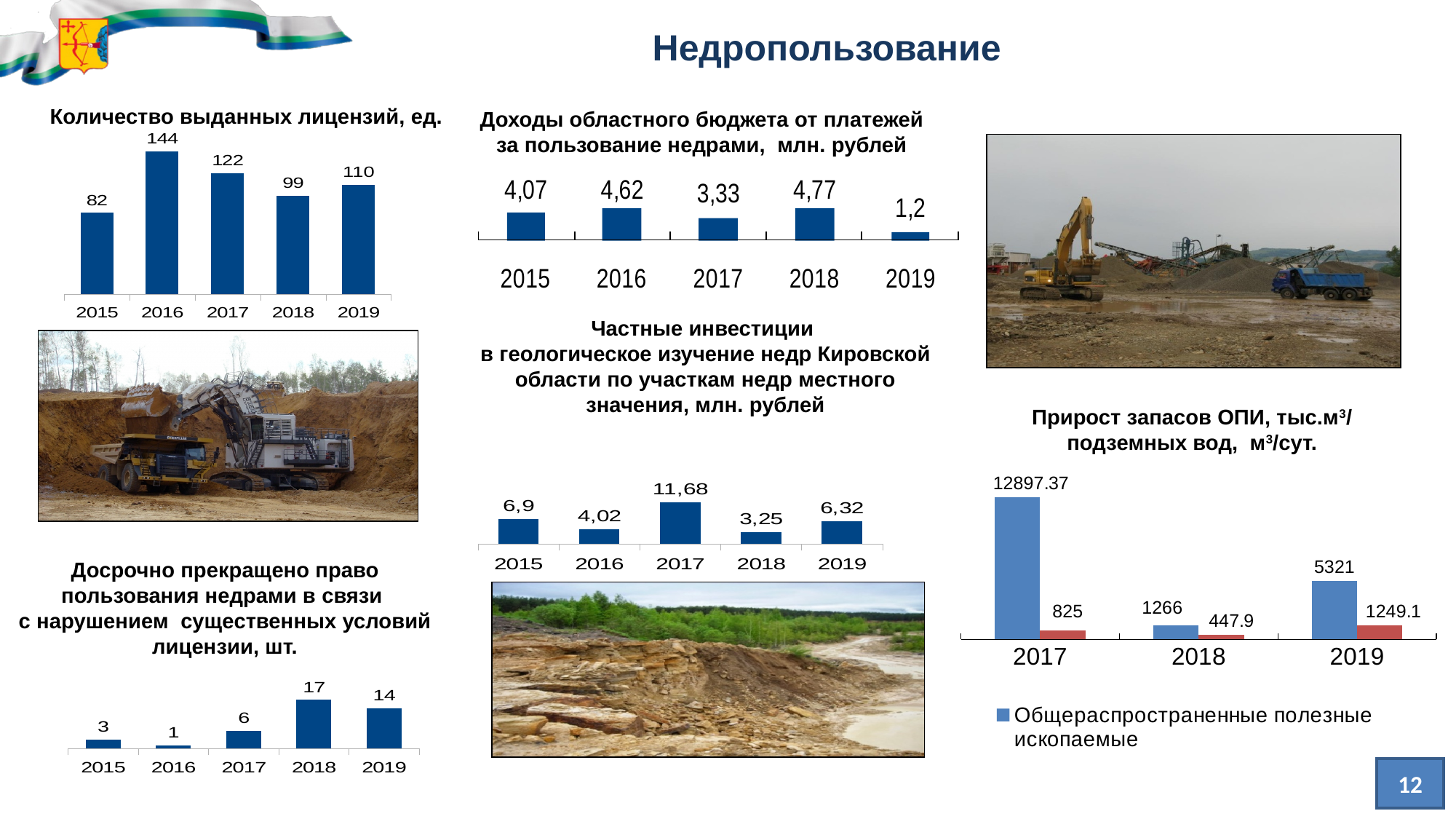
In the chart 'Доходы областного бюджета от платежей за пользование недрами, млн. рублей', what is the value for 2019? 1,2 In the chart 'Досрочно прекращено право пользования недрами в связи с нарушением существенных условий лицензии, шт.', how many years are shown on the x axis? 5 In the chart 'Частные инвестиции в геологическое изучение недр Кировской области по участкам недр местного значения, млн. рублей', which is larger, the value for 2015 or 2019? 2015 In the chart 'Количество выданных лицензий, ед.', which year has the lowest value? 2015 In the chart 'Прирост запасов ОПИ, тыс.м³/ подземных вод, м³/сут.', what is the value of the red bar for 2018? 447.9 In the chart 'Количество выданных лицензий, ед.', what is the value for 2016? 144 In the chart 'Доходы областного бюджета от платежей за пользование недрами, млн. рублей', which year has the highest value? 2018 In the chart 'Прирост запасов ОПИ, тыс.м³/ подземных вод, м³/сут.', what is the value of the blue bar for 2017? 12897.37 In the chart 'Количество выданных лицензий, ед.', what is the difference between the values for 2017 and 2018? 23 In the chart 'Частные инвестиции в геологическое изучение недр Кировской области по участкам недр местного значения, млн. рублей', what is the value for 2017? 11,68 In the chart 'Досрочно прекращено право пользования недрами в связи с нарушением существенных условий лицензии, шт.', what is the value for 2018? 17 What kind of chart is 'Количество выданных лицензий, ед.'? Bar chart